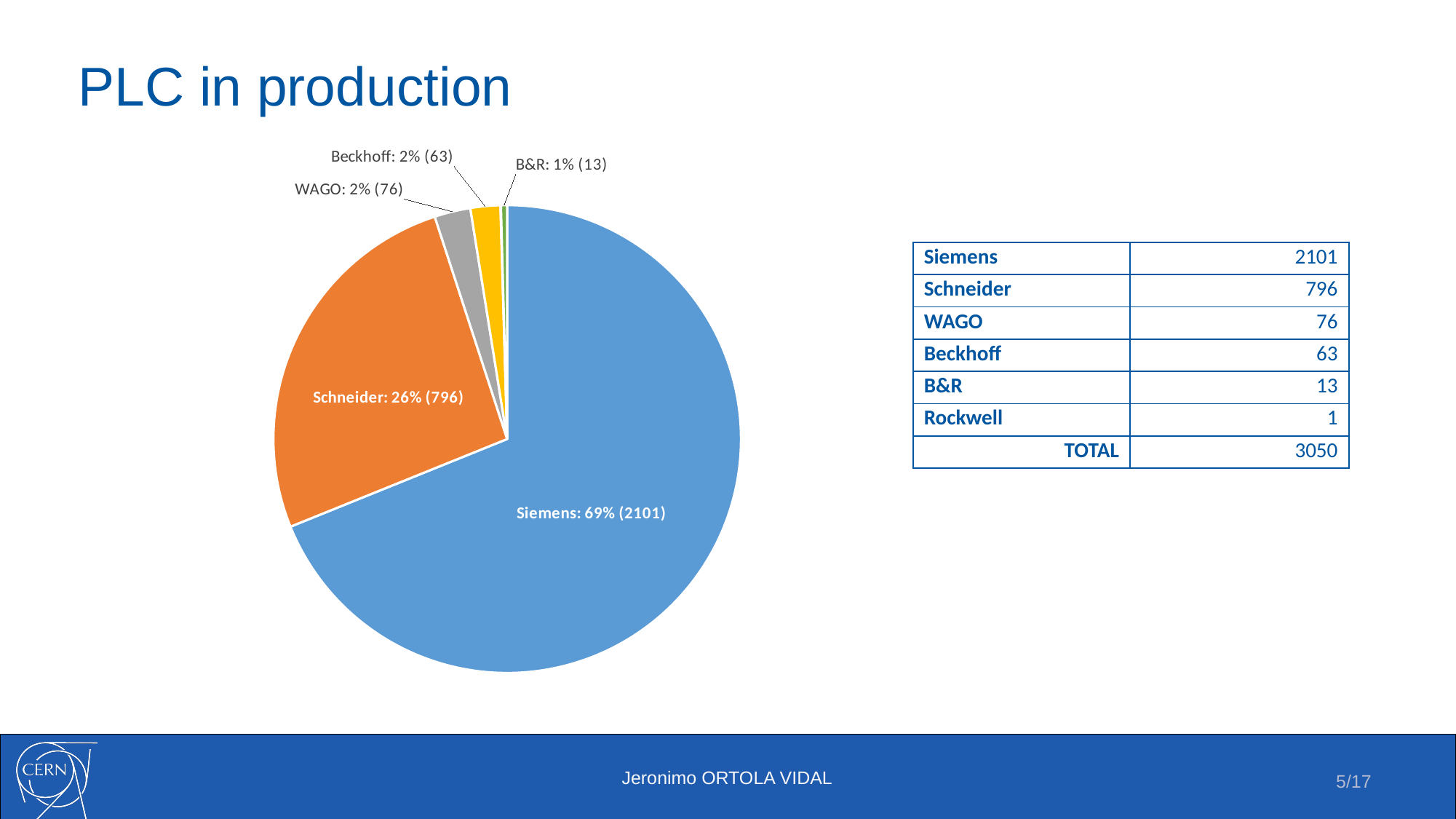
Which category has the largest slice in the pie chart? Siemens What is the value shown for Siemens in the pie chart? 2101 What kind of chart is shown on the slide? pie chart Which labelled category has the smallest slice in the pie chart? B&R What percentage share does Schneider have in the pie chart? 26% What percentage share does B&R have in the pie chart? 1% Which is larger in the pie chart, WAGO or Beckhoff? WAGO What colour is the Schneider slice in the pie chart? orange What is the difference between the WAGO value and the Beckhoff value in the pie chart? 13 What is the difference between the Siemens value and the Schneider value in the pie chart? 1305 What percentage share does Siemens have in the pie chart? 69% What is the value shown for WAGO in the pie chart? 76